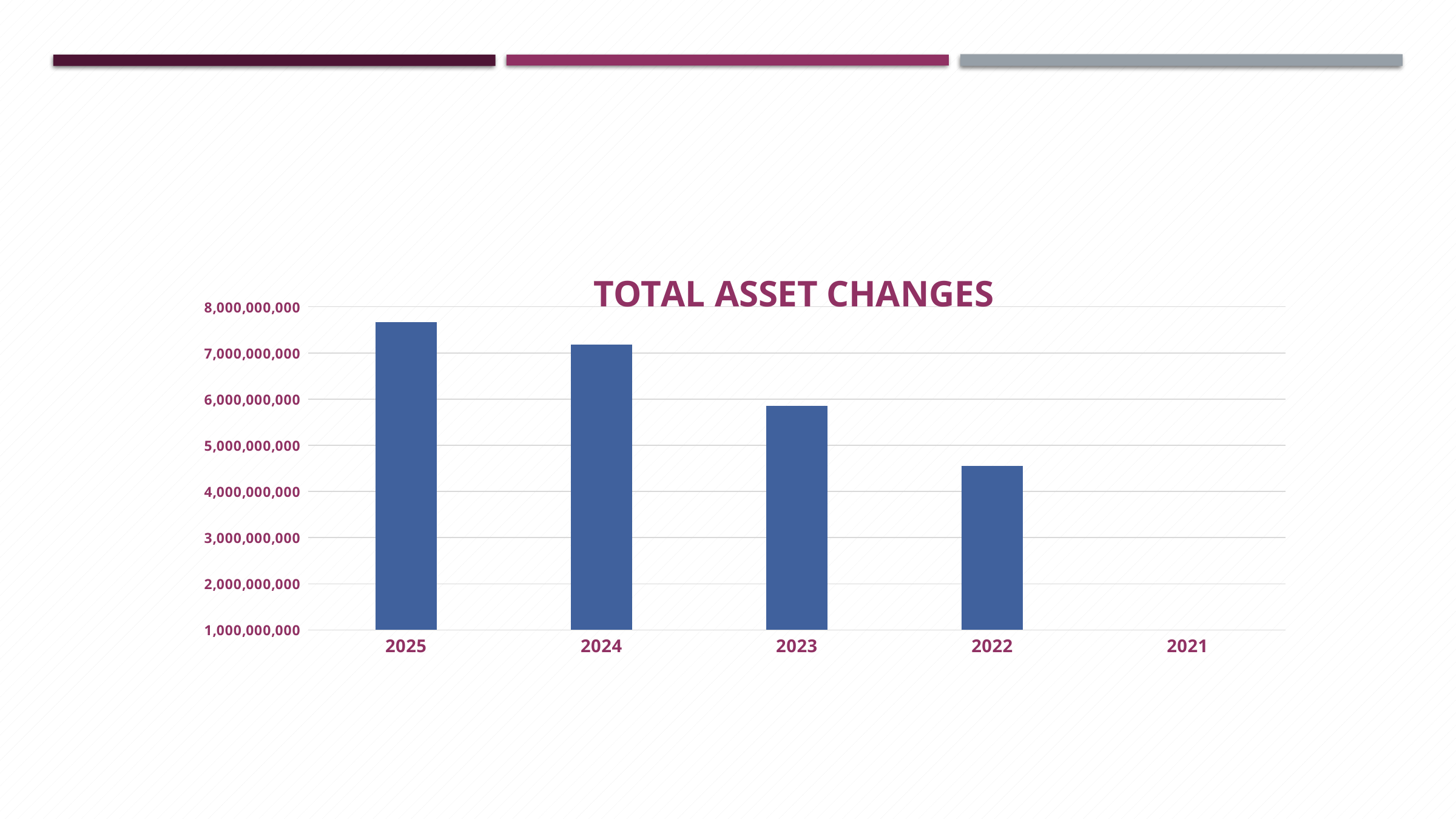
Is the value for 2025 greater or less than 7,000,000,000? greater Which is larger, the value for 2025 or the value for 2023? 2025 Do the bar values rise or fall moving from left to right along the x axis? fall What kind of chart is shown on the slide? bar chart Is the value for 2022 greater or less than 5,000,000,000? less Is the value for 2022 greater or less than 4,000,000,000? greater What is the title of the chart? TOTAL ASSET CHANGES Which is larger, the value for 2024 or the value for 2022? 2024 Which year has the highest value in the chart? 2025 How many years are labelled on the x axis of the chart? 5 Which year on the x axis has no visible bar? 2021